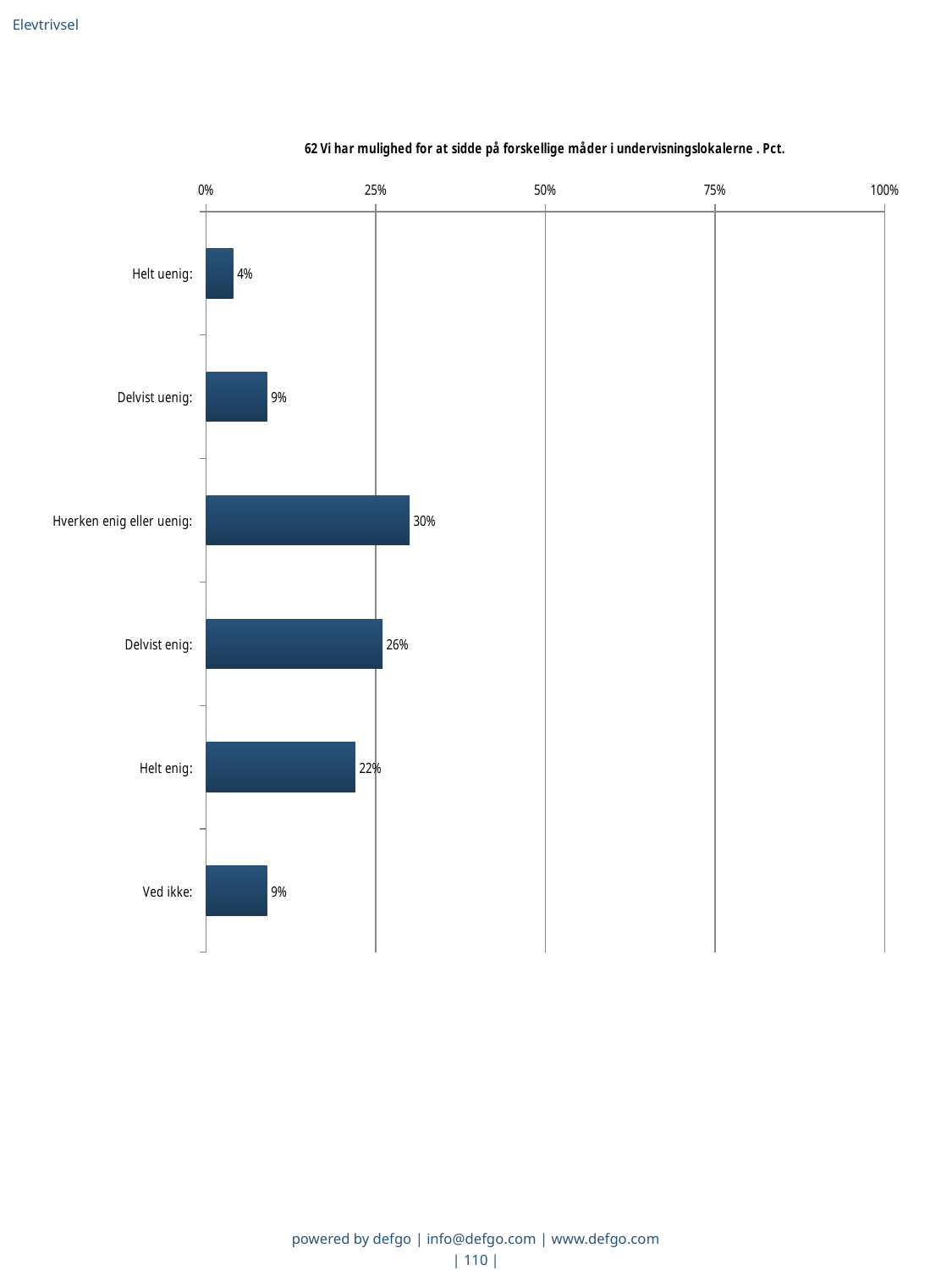
What is the value for "Delvist enig"? 26% What is the value for "Helt enig"? 22% How many categories are shown in the chart? 6 Which category has the highest value? Hverken enig eller uenig What is the difference between the values for "Hverken enig eller uenig" and "Delvist enig"? 4% Which is larger, the value for "Delvist enig" or the value for "Helt enig"? Delvist enig Which two categories share the same value of 9%? Delvist uenig and Ved ikke Is the value for "Hverken enig eller uenig" greater or less than 25%? greater What kind of chart is shown on the slide? bar chart What is the value for "Helt uenig"? 4% Which category has the lowest value? Helt uenig What is the value for "Hverken enig eller uenig"? 30%